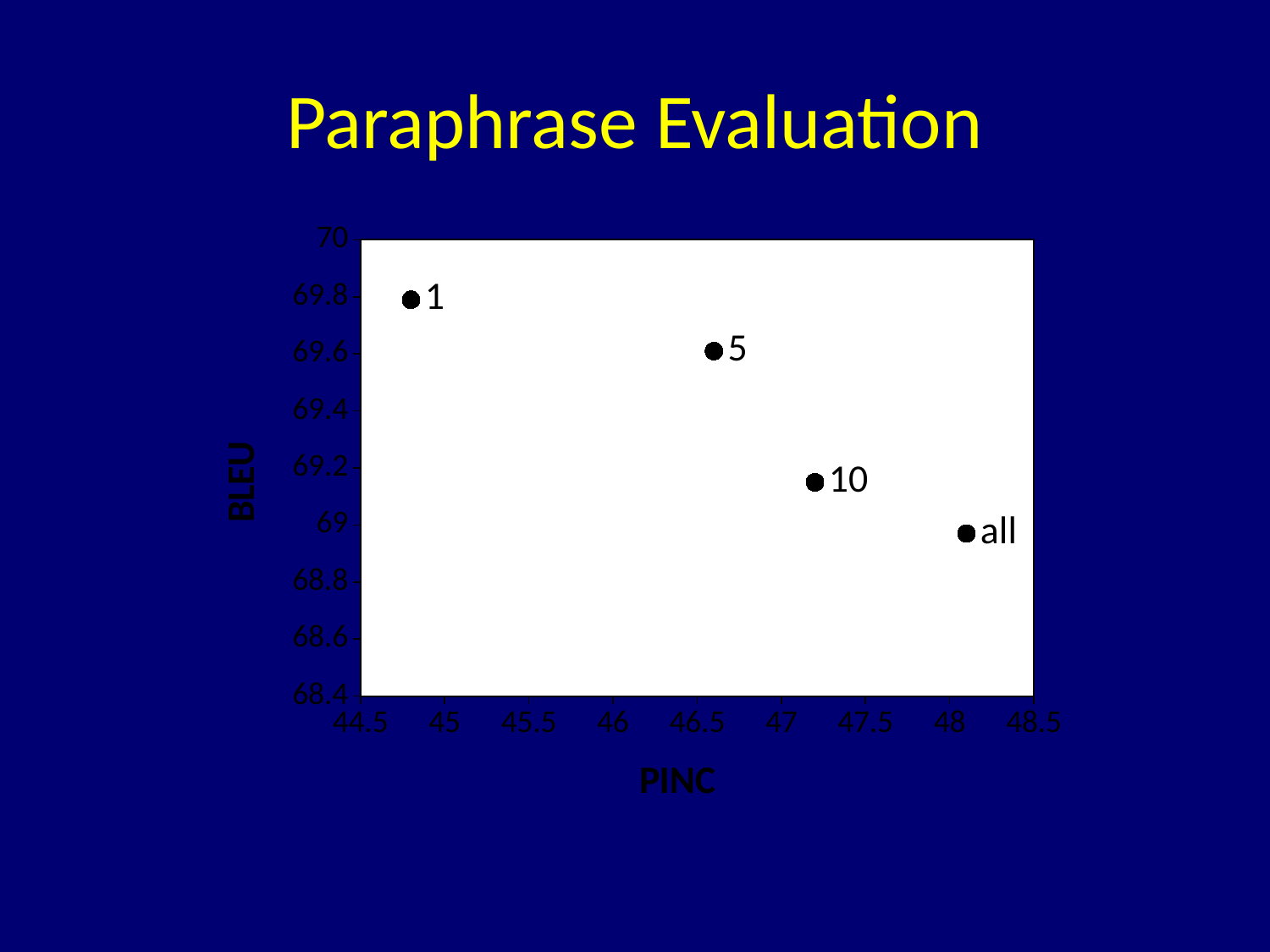
Which point has the highest PINC value? all Is the PINC value for point 10 greater or less than 47? greater Which point has the lowest PINC value? 1 As PINC increases along the x axis, does BLEU rise or fall? fall Which point has the lowest BLEU score? all Which has a higher BLEU score, point 5 or point 10? 5 Is the BLEU value for point 1 greater or less than 69.6? greater Is the BLEU value for point "all" greater or less than 69? less How many data points are plotted on the chart? 4 Which point has the highest BLEU score? 1 What kind of chart is shown on the slide? scatter chart What is the label of the x axis? PINC